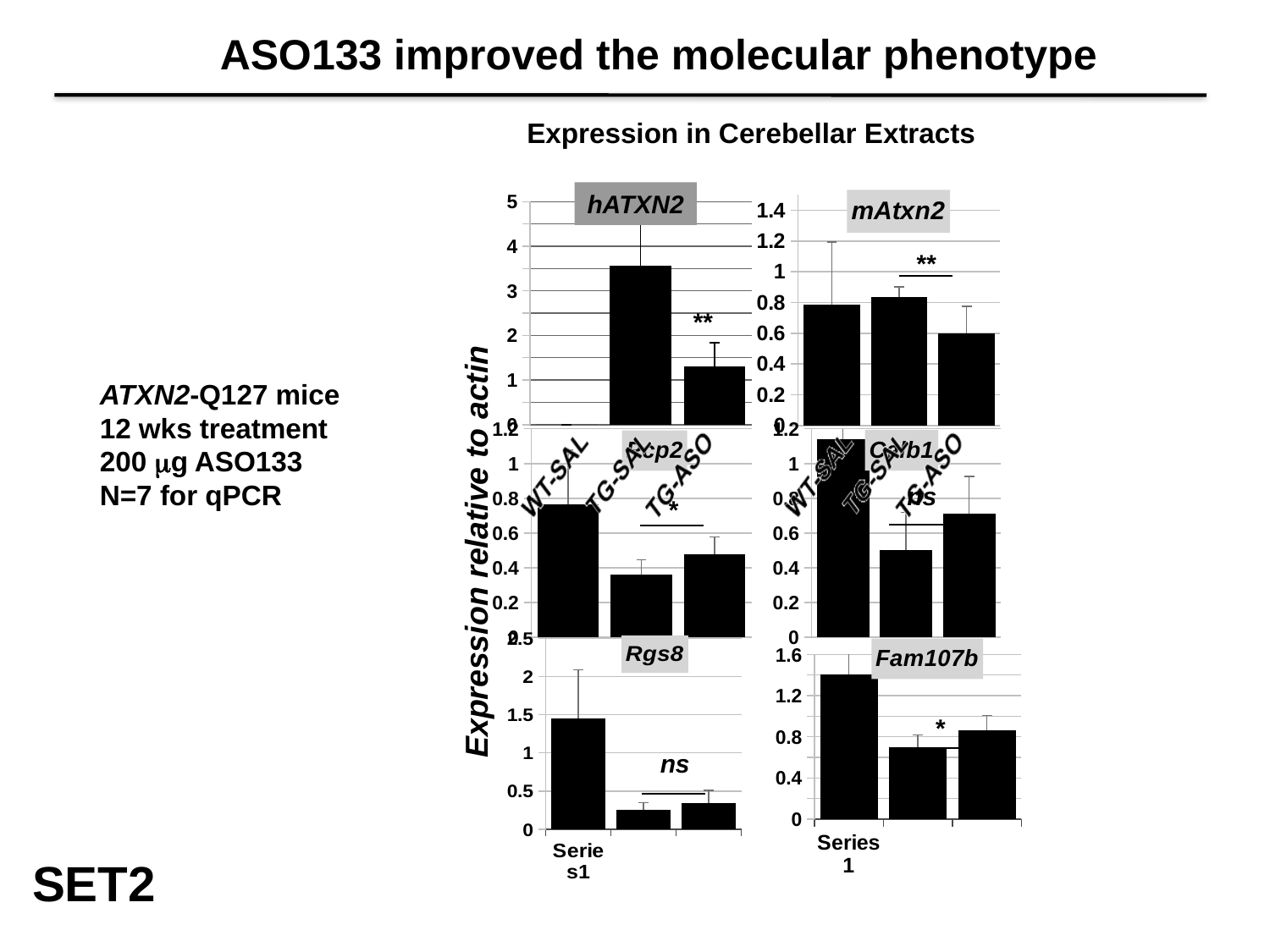
In the hATXN2 chart, is the value for TG-SAL greater or less than 3? greater What kind of chart is the hATXN2 chart? bar chart In the Rgs8 chart, is the value of the leftmost bar greater or less than 1? greater How many separate charts are shown on the slide? 6 In the hATXN2 chart, is the value for TG-ASO greater or less than 2? less In the hATXN2 chart, which category has the highest value? TG-SAL In the mAtxn2 chart, which is larger, the value for TG-SAL or the value for TG-ASO? TG-SAL In the Fam107b chart, which bar is the highest? the leftmost bar In the hATXN2 chart, which category has the lowest value? WT-SAL What is the label on the shared vertical axis of the charts? Expression relative to actin In the mAtxn2 chart, which category has the lowest value? TG-ASO